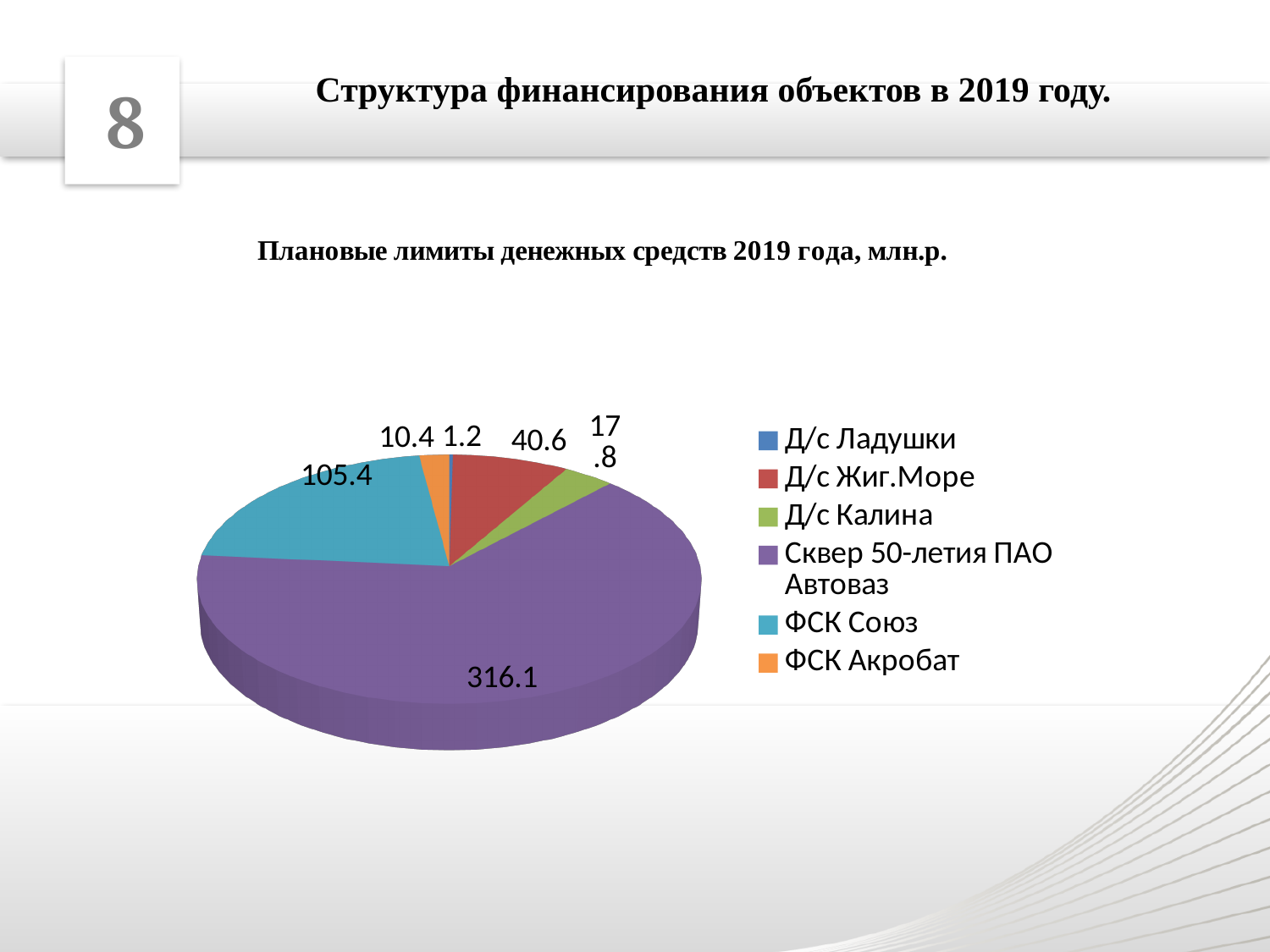
What is the difference between the values for Сквер 50-летия ПАО Автоваз and ФСК Союз? 210.7 What is the title of the chart? Плановые лимиты денежных средств 2019 года, млн.р. Which category has the largest slice of the pie? Сквер 50-летия ПАО Автоваз How many categories does the legend list? 6 Which is larger, the value for Д/с Жиг.Море or the value for Д/с Калина? Д/с Жиг.Море What is the value for Сквер 50-летия ПАО Автоваз? 316.1 What is the value for ФСК Союз? 105.4 Which category has the smallest slice of the pie? Д/с Ладушки What kind of chart is shown on the slide? Pie chart What is the value for ФСК Акробат? 10.4 What is the value for Д/с Жиг.Море? 40.6 What is the value for Д/с Калина? 17.8